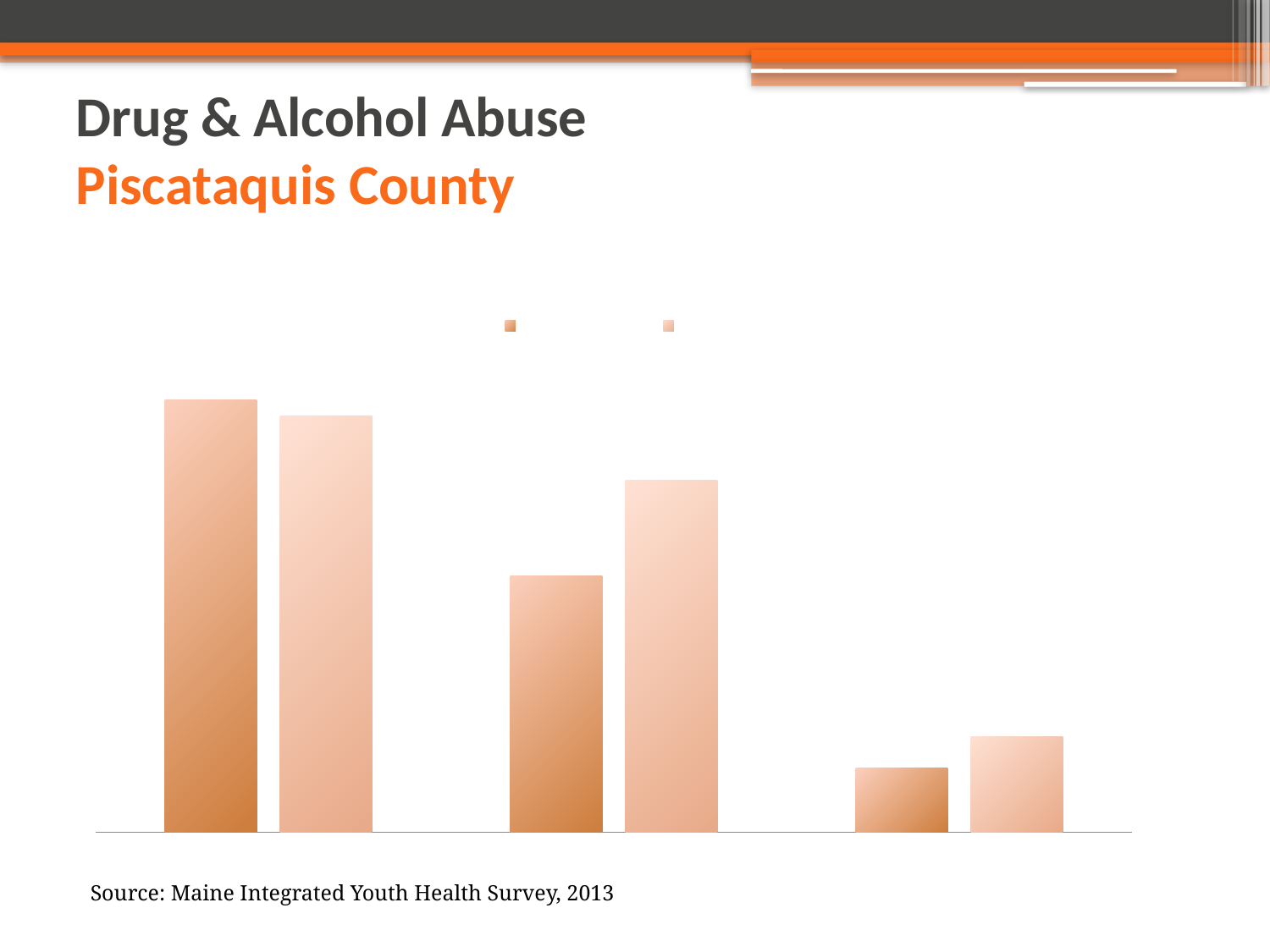
How many bars are plotted in total in the chart? 6 How many series does the legend list? 2 In the right group of bars, which bar is taller, the darker orange one or the lighter orange one? the lighter orange one Do the bar heights generally rise or fall from left to right across the chart? fall In the left group of bars, is the darker orange bar taller or shorter than the lighter orange bar? taller Which group of bars is the tallest: the left, middle, or right group? left In the middle group of bars, is the darker orange bar taller or shorter than the lighter orange bar? shorter How many groups of bars are plotted in the chart? 3 Which group of bars is the shortest: the left, middle, or right group? right Which county is named in the slide title? Piscataquis County What source is cited below the chart? Maine Integrated Youth Health Survey, 2013 What kind of chart is shown on the slide? bar chart